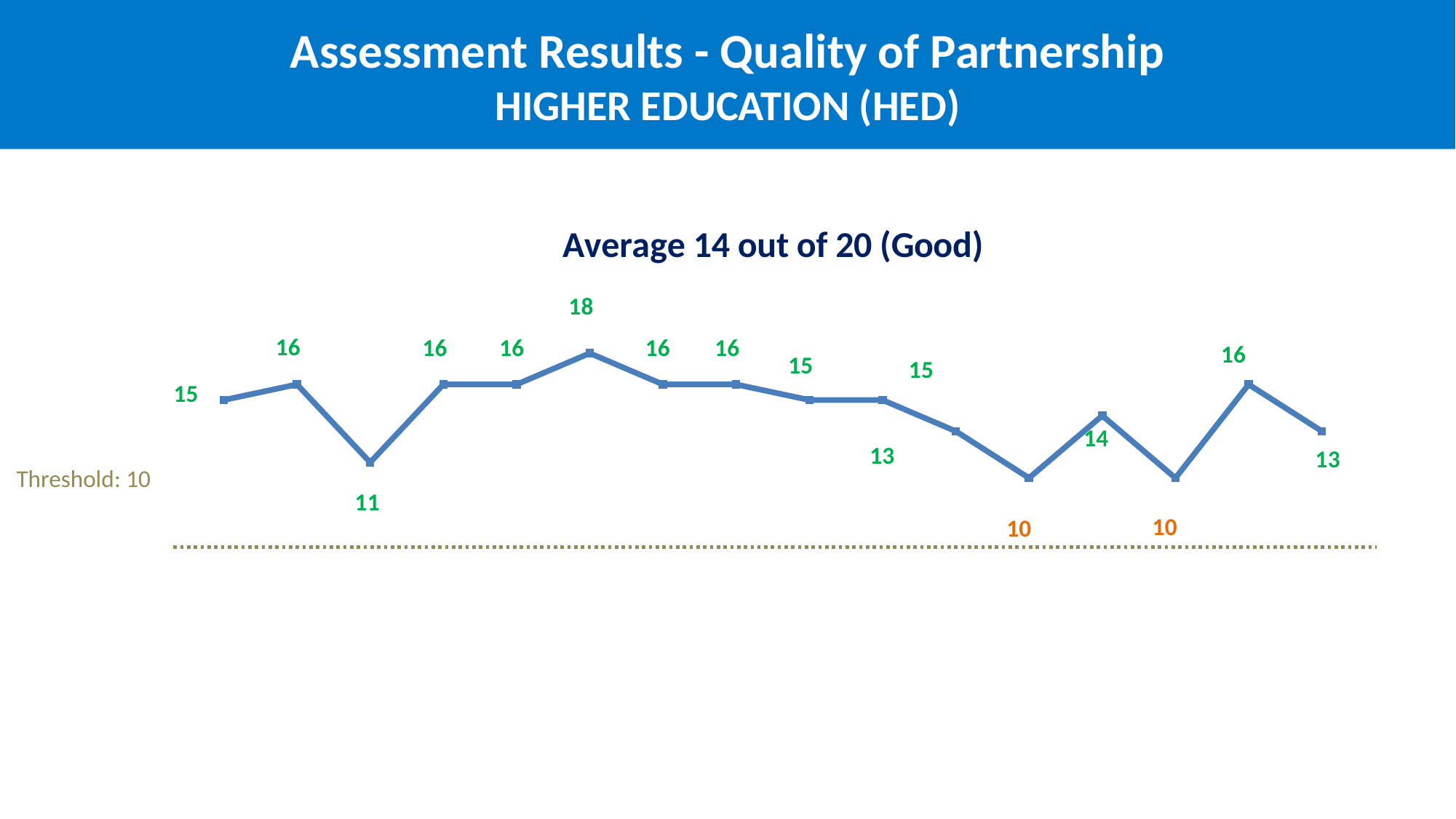
What is the value of the last data point on the line chart? 13 What is the highest value plotted on the line chart? 18 What kind of chart is shown on the slide? line chart What average score is stated above the chart? 14 out of 20 (Good) What is the value of the first data point on the line chart? 15 What is the lowest value plotted on the line chart? 10 What threshold value is indicated by the dotted line on the chart? 10 What is the difference between the highest value (18) and the lowest value (10) on the line chart? 8 How many data points are plotted on the line chart? 16 What is the value of the third data point on the line chart? 11 How many data points on the line chart have a value of 10? 2 Which is larger on the line chart: the value of the sixth data point or the value of the third data point? the sixth data point